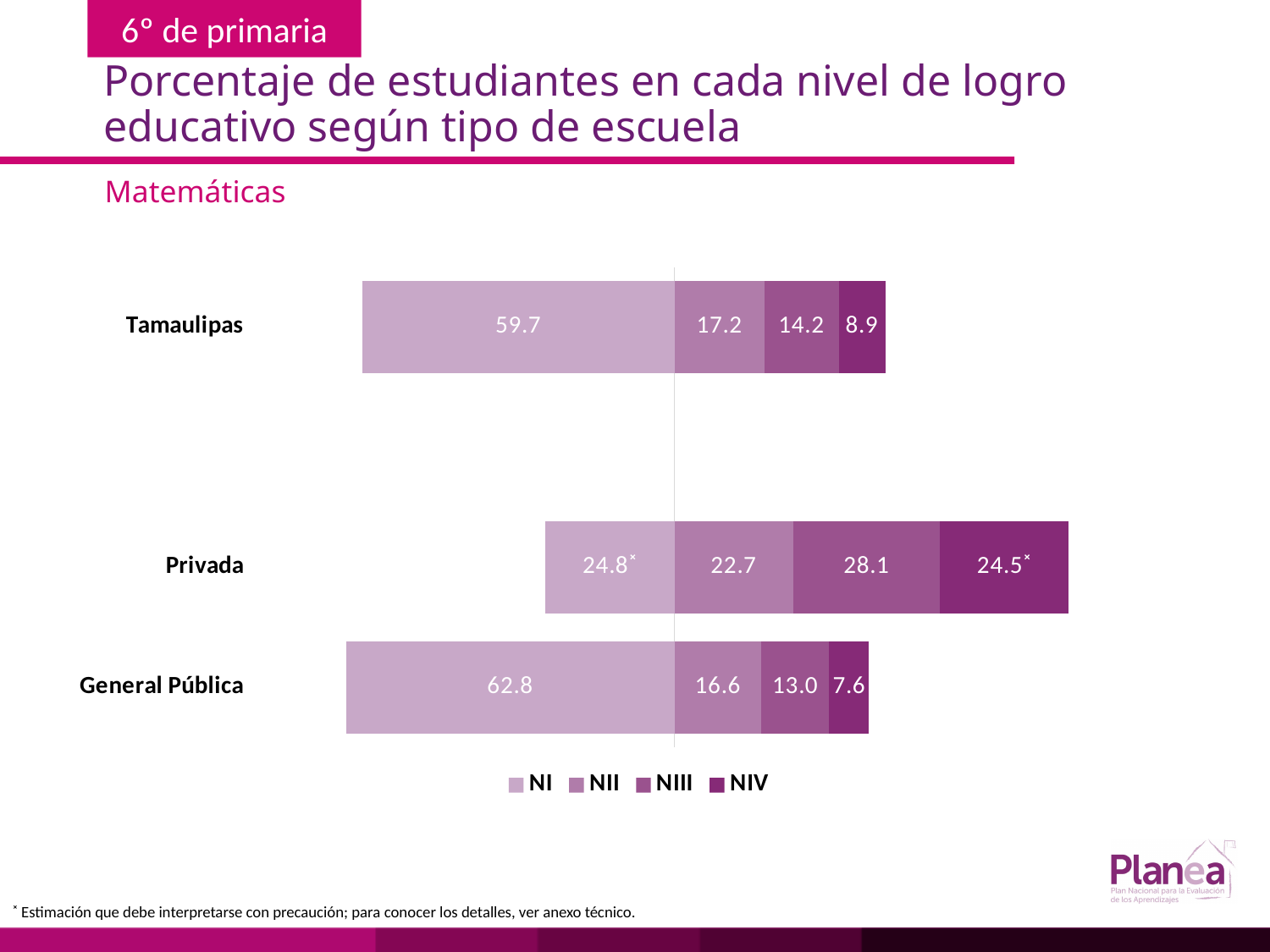
What is the NI value for Tamaulipas? 59.7 Which category has the lowest NIV value? General Pública How many categories (school types) are plotted in the chart? 3 What is the difference between the NI values of General Pública and Tamaulipas? 3.1 Which category has the highest NI value? General Pública What kind of chart is shown on the slide? Stacked bar chart Which subject is the chart about, according to the subtitle? Matemáticas How many series does the legend list? 4 What is the NIV value for General Pública? 7.6 What is the NII value for General Pública? 16.6 Which is larger, the NIII value for Privada or the NIII value for Tamaulipas? Privada What is the NIII value for Privada? 28.1